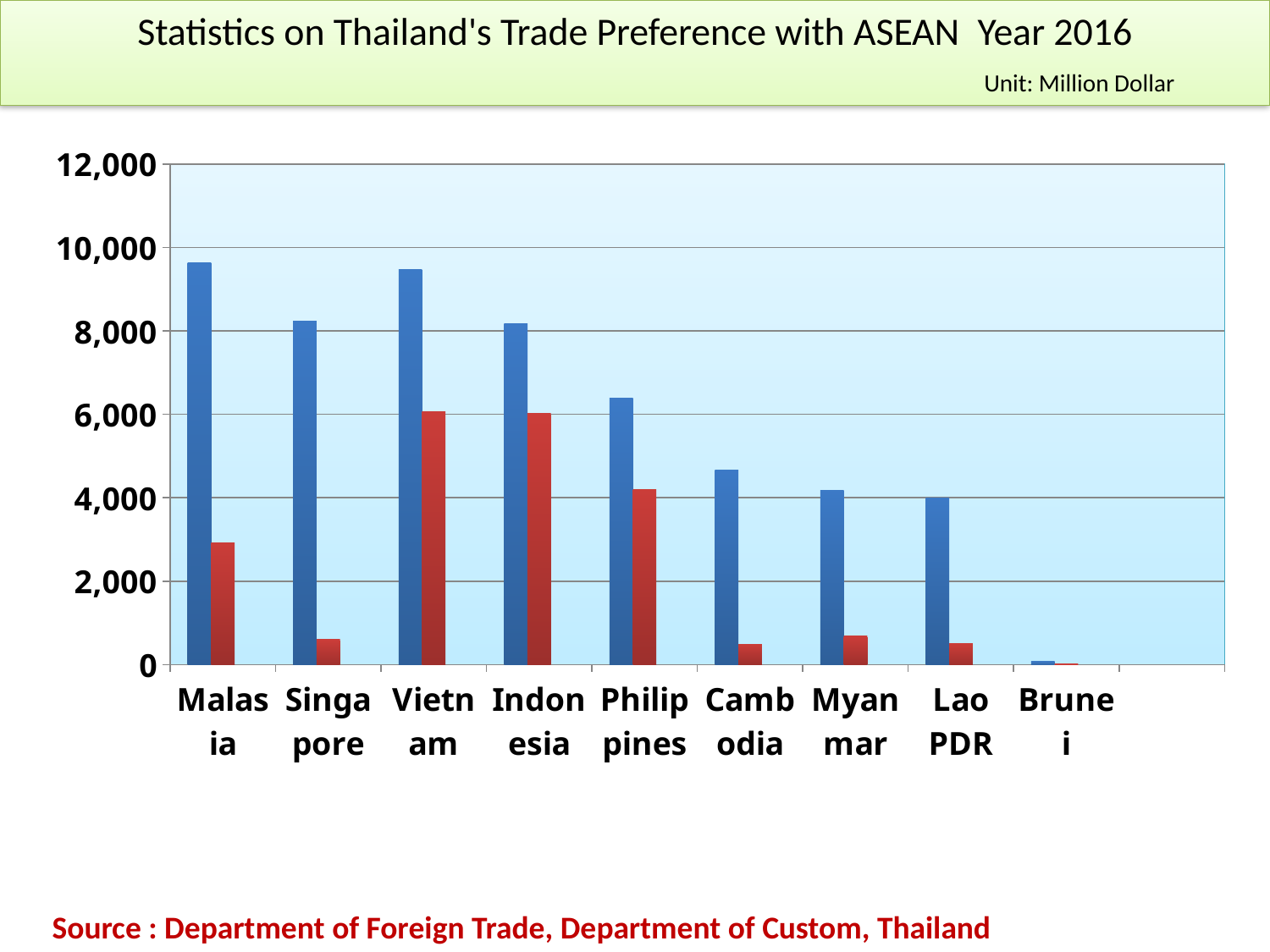
Is the red bar for Malasia greater or less than 2,000? greater Is the blue bar for Cambodia greater or less than 4,000? greater Is the blue bar for Malasia greater or less than 8,000? greater Which country has the lowest blue bar in the chart? Brunei What unit is stated for the values in the chart? Million Dollar What kind of chart is shown on the slide? bar chart How many countries are shown on the x axis of the chart? 9 Which is larger, the blue bar for Malasia or the blue bar for Singapore? Malasia Do the blue bars generally rise or fall from left to right across the countries? fall